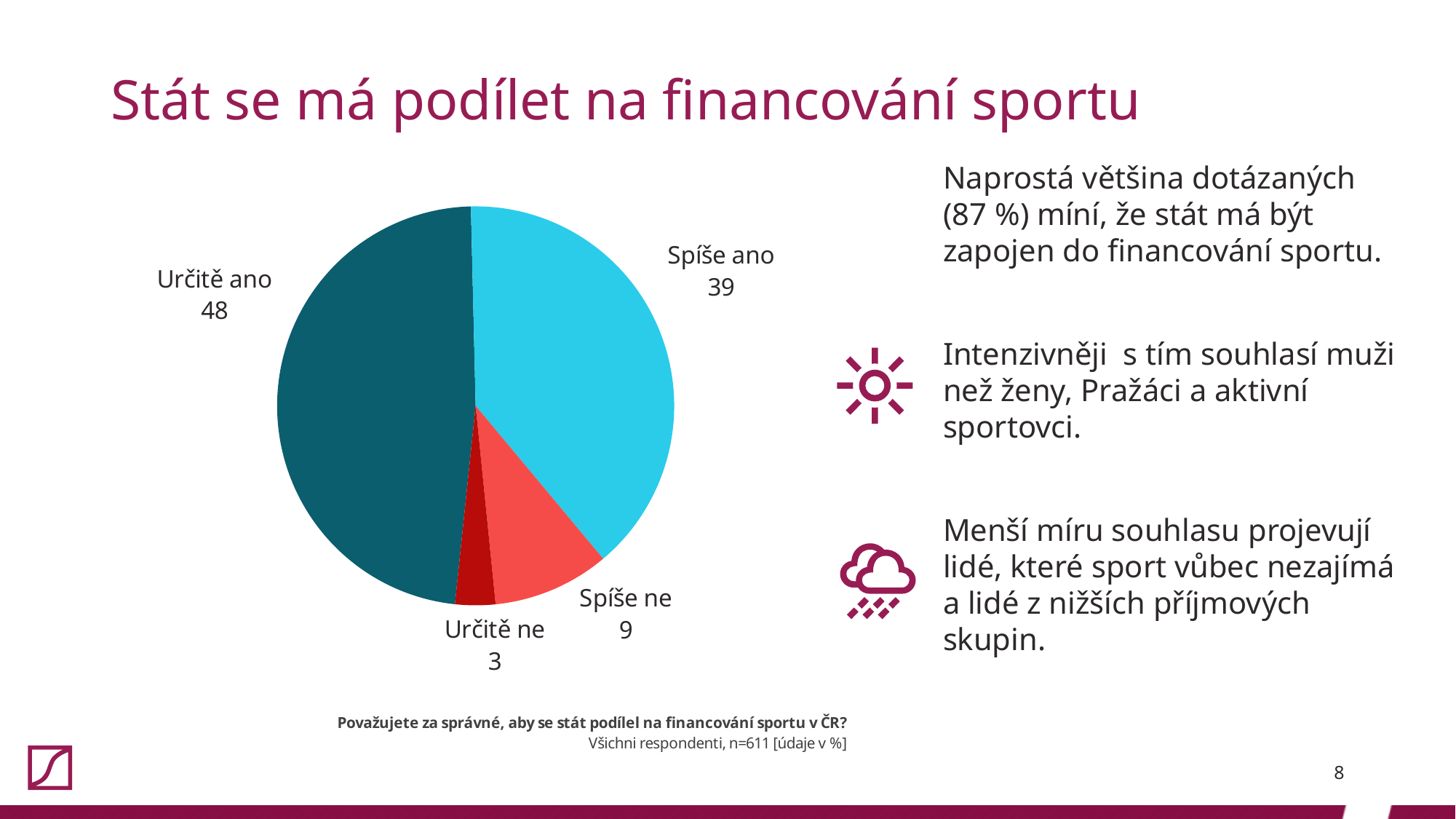
What colour is the "Spíše ano" slice of the pie chart? Light blue What value is shown for the "Určitě ano" slice of the pie chart? 48 Which category has the smallest slice in the pie chart? Určitě ne What value is shown for the "Spíše ne" slice of the pie chart? 9 What value is shown for the "Určitě ne" slice of the pie chart? 3 What is the difference between the values for "Určitě ano" and "Spíše ano"? 9 Which category has the largest slice in the pie chart? Určitě ano How many slices does the pie chart have? 4 What type of chart is shown on the slide? Pie chart What is the combined value of the "Určitě ano" and "Spíše ano" slices? 87 What value is shown for the "Spíše ano" slice of the pie chart? 39 Which is larger, the value for "Spíše ne" or the value for "Určitě ne"? Spíše ne